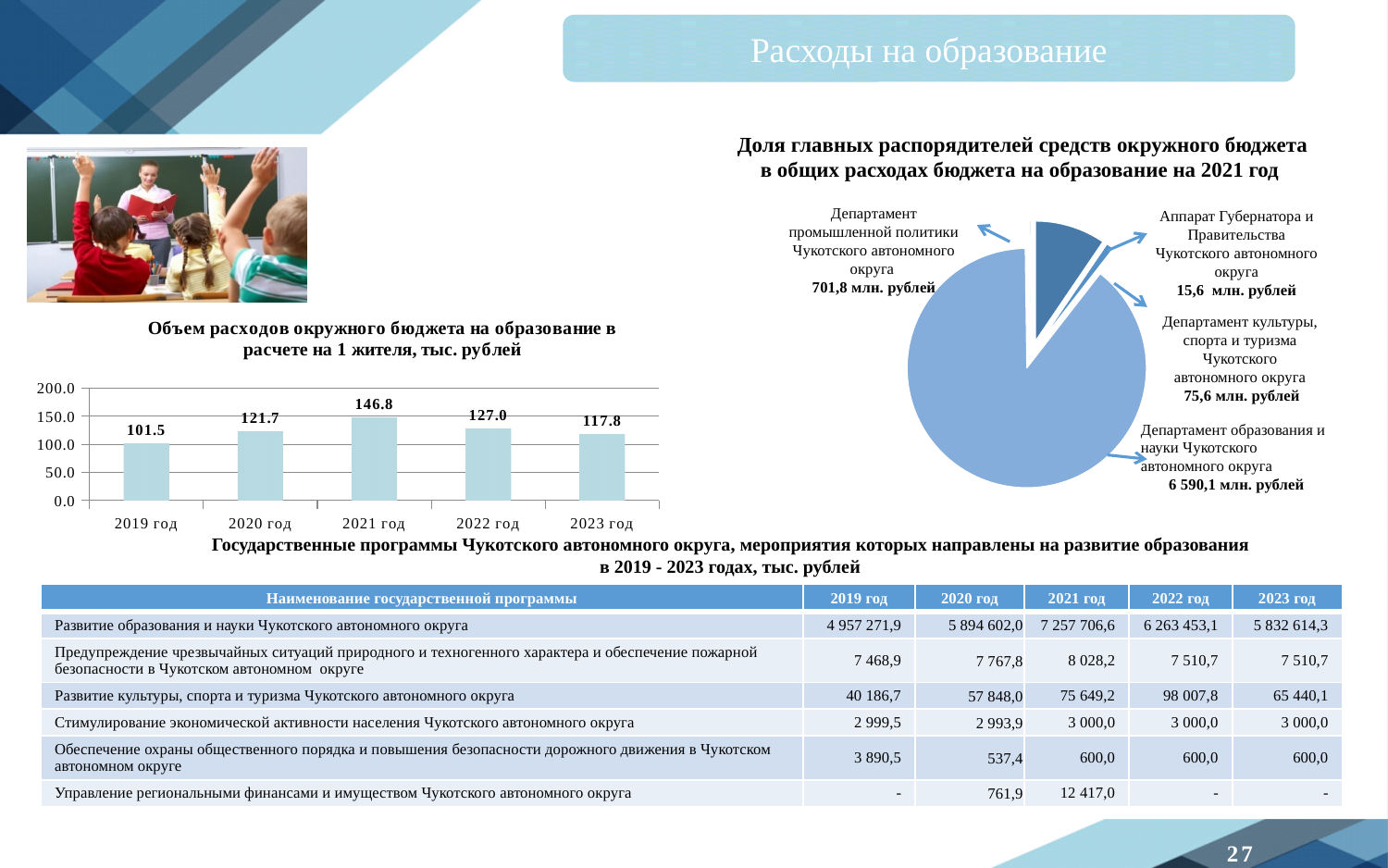
On the bar chart 'Объем расходов окружного бюджета на образование в расчете на 1 жителя', which year has the highest value? 2021 год On the bar chart 'Объем расходов окружного бюджета на образование в расчете на 1 жителя', do the values rise or fall from 2021 год to 2023 год? fall On the bar chart 'Объем расходов окружного бюджета на образование в расчете на 1 жителя', what is the difference between the values for 2021 год and 2019 год? 45.3 What kind of chart is 'Объем расходов окружного бюджета на образование в расчете на 1 жителя'? bar chart On the bar chart 'Объем расходов окружного бюджета на образование в расчете на 1 жителя', how many years are shown? 5 On the bar chart 'Объем расходов окружного бюджета на образование в расчете на 1 жителя', which is larger, the value for 2022 год or 2023 год? 2022 год On the bar chart 'Объем расходов окружного бюджета на образование в расчете на 1 жителя', what is the value for 2021 год? 146.8 On the pie chart 'Доля главных распорядителей средств окружного бюджета', which distributor has the smallest value? Аппарат Губернатора и Правительства Чукотского автономного округа On the bar chart 'Объем расходов окружного бюджета на образование в расчете на 1 жителя', which year has the lowest value? 2019 год On the pie chart 'Доля главных распорядителей средств окружного бюджета', how many slices are shown? 4 On the bar chart 'Объем расходов окружного бюджета на образование в расчете на 1 жителя', what is the value for 2019 год? 101.5 On the pie chart 'Доля главных распорядителей средств окружного бюджета', what is the value for Департамент образования и науки Чукотского автономного округа? 6 590,1 млн. рублей